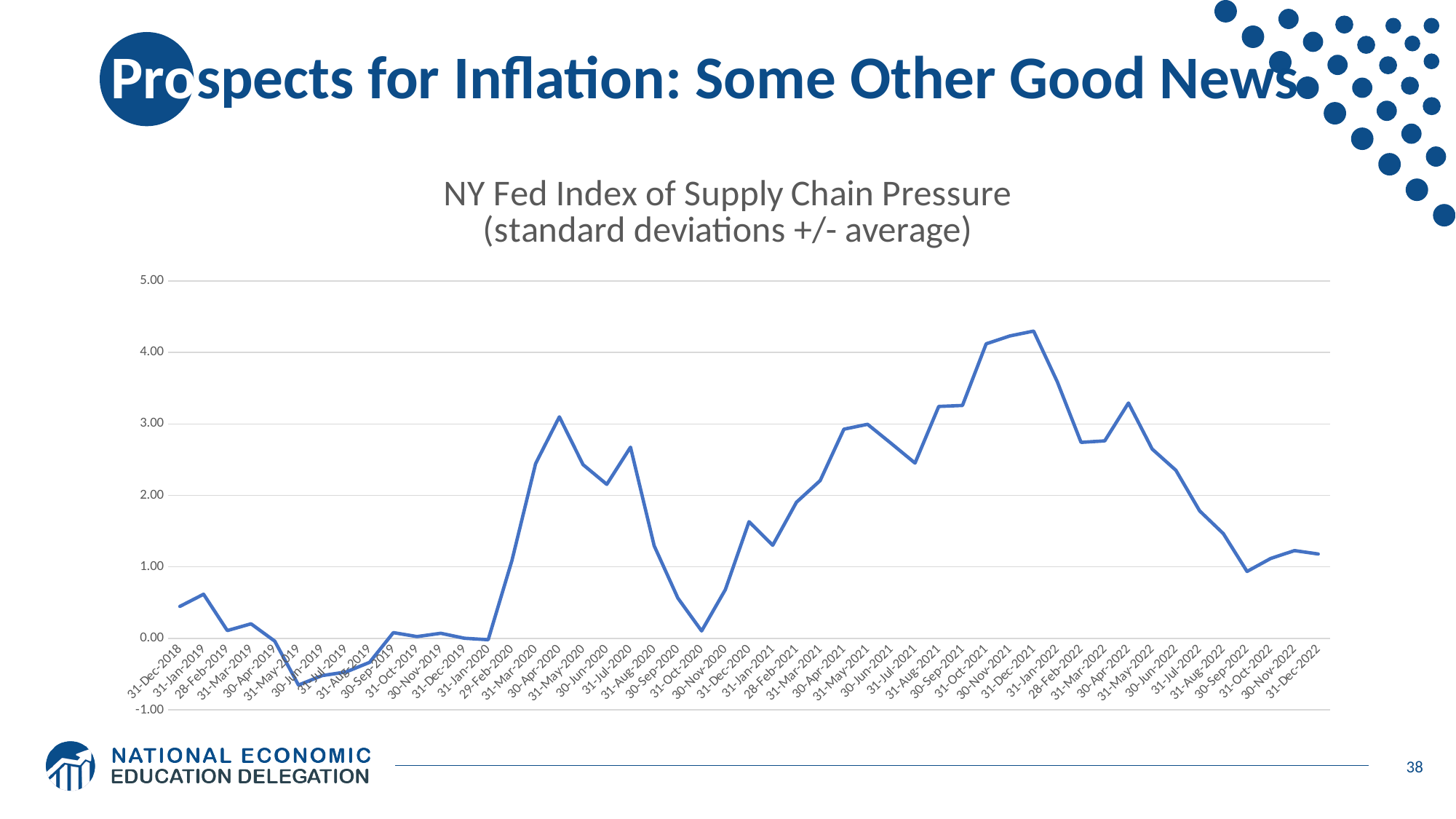
Is the value for 30-Apr-2020 greater or less than 2.00? greater Is the value for 31-Oct-2020 greater or less than 1.00? less What is the title of the chart? NY Fed Index of Supply Chain Pressure (standard deviations +/- average) Is the value for 31-Dec-2021 greater or less than 4.00? greater Which is larger, the value for 31-Dec-2021 or the value for 30-Apr-2020? 31-Dec-2021 What kind of chart is shown on the slide? Line chart At which date does the index reach its highest value? 31-Dec-2021 How many monthly data points are plotted on the chart? 49 What is the highest value shown on the vertical axis? 5.00 Does the index rise or fall between 31-Dec-2021 and 30-Sep-2022? fall